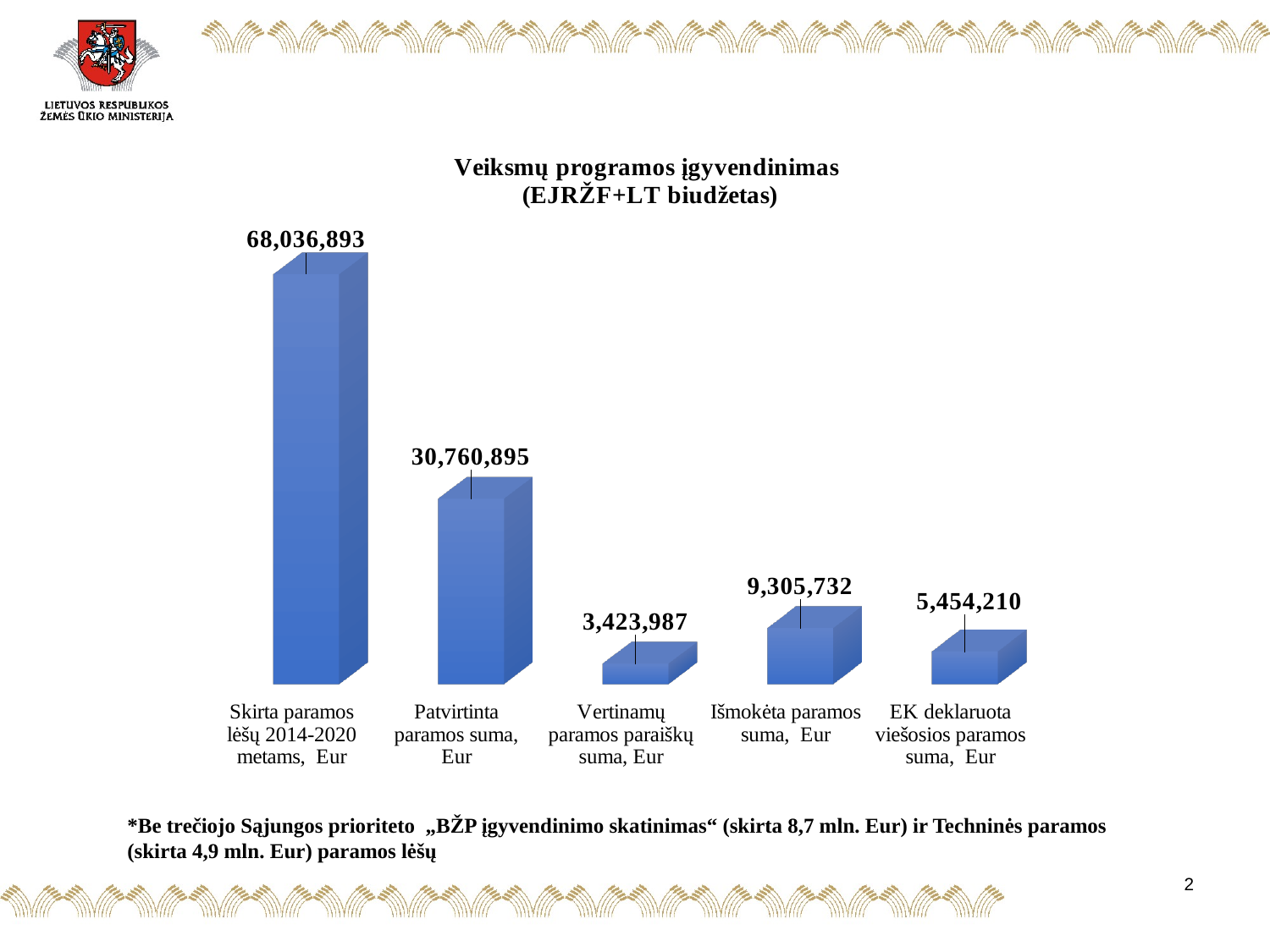
What is the value for "Išmokėta paramos suma, Eur"? 9,305,732 What is the difference between "Išmokėta paramos suma, Eur" and "EK deklaruota viešosios paramos suma, Eur"? 3,851,522 What kind of chart is shown on the slide? Bar chart Which is larger: "Išmokėta paramos suma, Eur" or "EK deklaruota viešosios paramos suma, Eur"? Išmokėta paramos suma, Eur What is the value for "EK deklaruota viešosios paramos suma, Eur"? 5,454,210 Which category has the lowest value? Vertinamų paramos paraiškų suma, Eur What is the difference between "Skirta paramos lėšų 2014-2020 metams, Eur" and "Patvirtinta paramos suma, Eur"? 37,275,998 What is the value for "Patvirtinta paramos suma, Eur"? 30,760,895 What is the value for "Skirta paramos lėšų 2014-2020 metams, Eur"? 68,036,893 What is the value for "Vertinamų paramos paraiškų suma, Eur"? 3,423,987 Which category has the highest value? Skirta paramos lėšų 2014-2020 metams, Eur How many categories are shown in the chart? 5